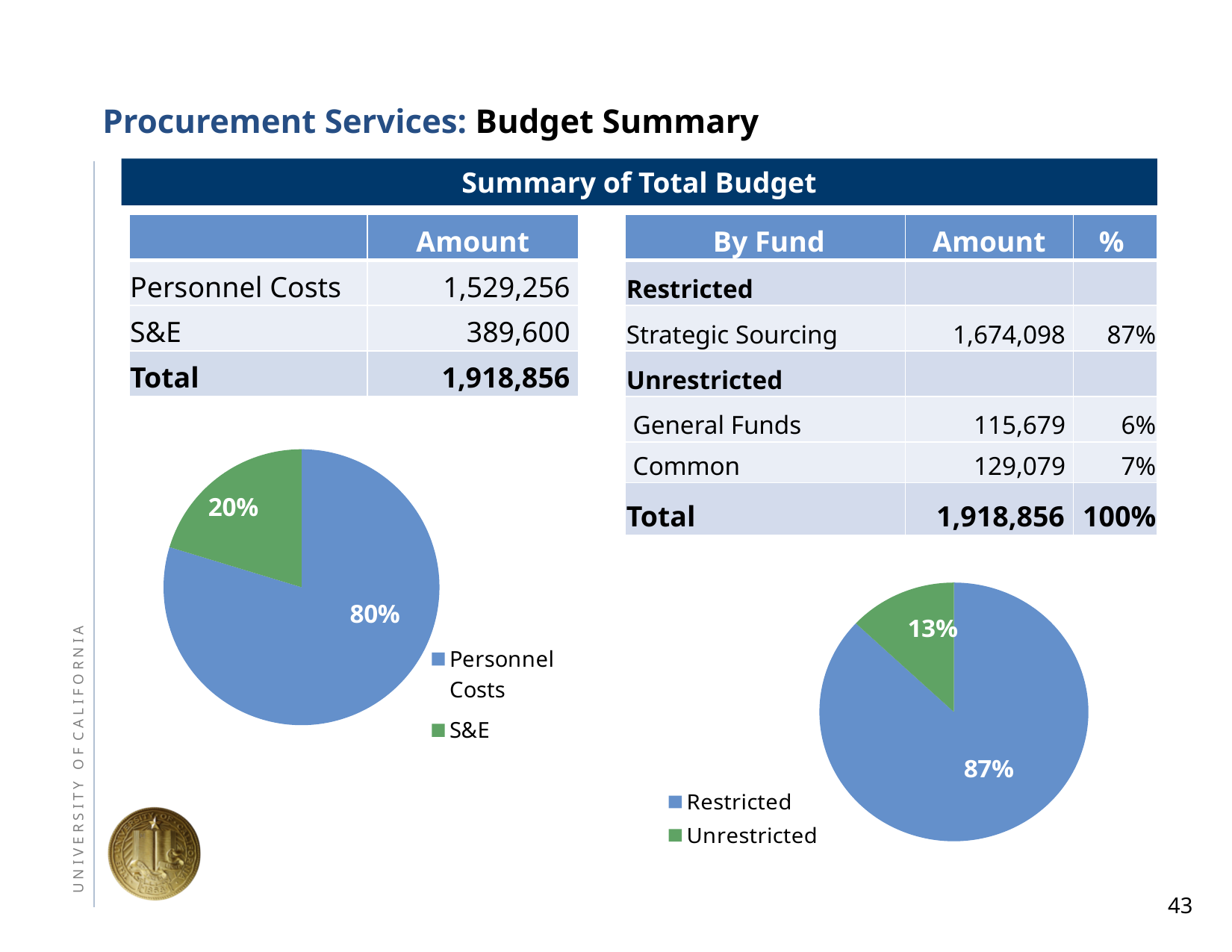
In the pie chart on the left, what is the difference in percentage points between Personnel Costs and S&E? 60 In the pie chart on the right, which slice is the smallest? Unrestricted What type of chart is the chart on the left? Pie chart In the pie chart on the right, what share does Restricted have? 87% In the pie chart on the left, which is larger, Personnel Costs or S&E? Personnel Costs How many slices does the pie chart on the right have? 2 In the pie chart on the right, what share does Unrestricted have? 13% In the pie chart on the left, what share does S&E have? 20% In the pie chart on the right, what is the difference in percentage points between Restricted and Unrestricted? 74 In the pie chart on the left, which slice is the largest? Personnel Costs In the pie chart on the right, what colour is the Unrestricted slice? Green